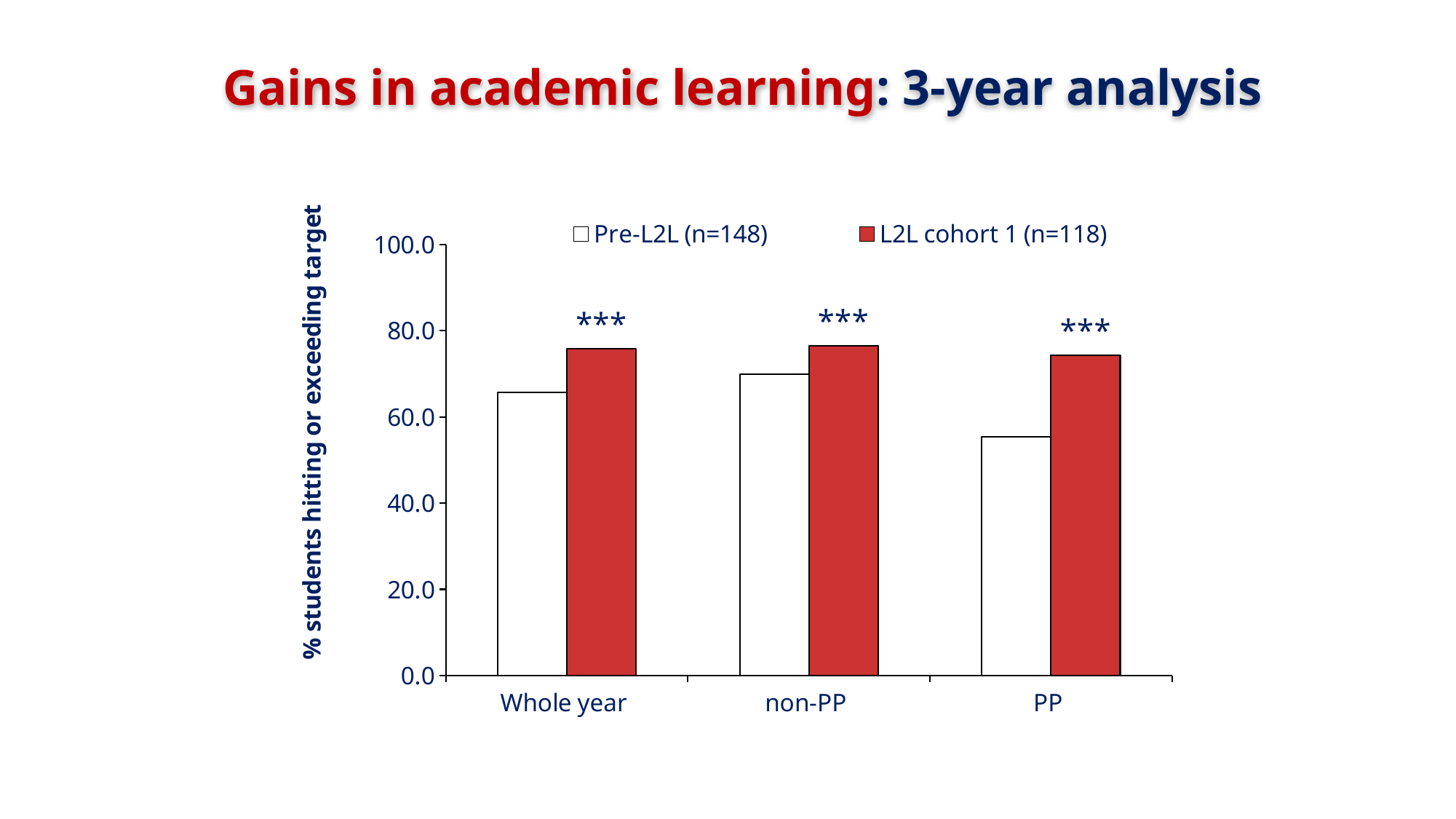
For PP, which is larger: Pre-L2L (n=148) or L2L cohort 1 (n=118)? L2L cohort 1 (n=118) What kind of chart is shown on the slide? bar chart How many series does the legend list? 2 Which series is shown in red? L2L cohort 1 (n=118) What is the label of the y axis? % students hitting or exceeding target Which category has the lowest Pre-L2L (n=148) value? PP Is the Pre-L2L (n=148) value for non-PP greater or less than 60.0? greater Which category has the highest Pre-L2L (n=148) value? non-PP For Whole year, which is larger: Pre-L2L (n=148) or L2L cohort 1 (n=118)? L2L cohort 1 (n=118) Is the L2L cohort 1 (n=118) value for Whole year greater or less than 80.0? less Is the Pre-L2L (n=148) value for PP greater or less than 60.0? less How many categories are shown on the x axis? 3